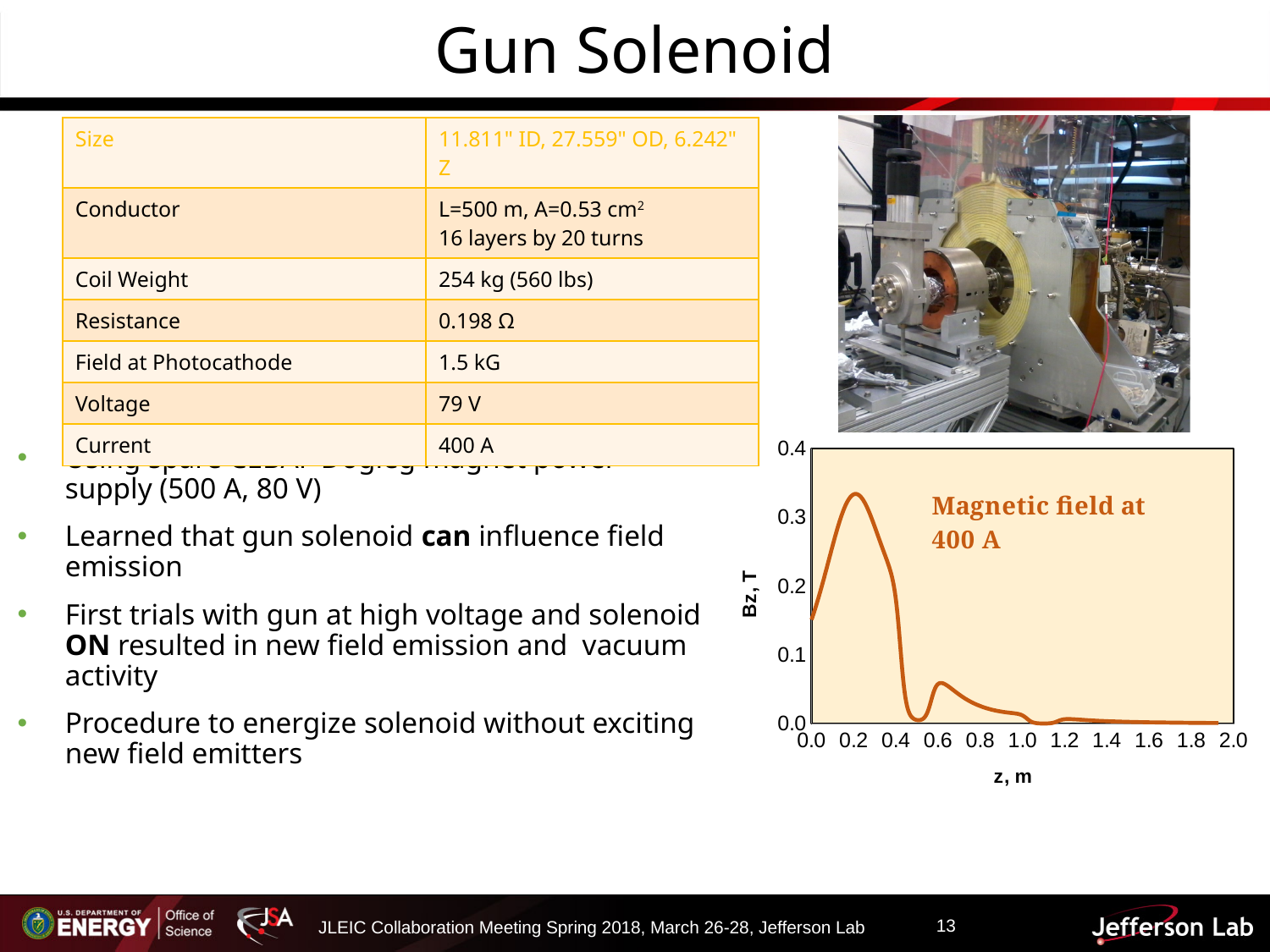
What is the title printed inside the chart? Magnetic field at 400 A Is the value of Bz at z = 0.2 m greater or less than 0.3? greater What is the label of the y axis of the chart? Bz, T What is the highest value shown on the y axis of the chart? 0.4 Is the value of Bz at z = 0.0 m greater or less than 0.2? less Is the value of Bz at z = 0.0 m greater or less than 0.1? greater Does Bz rise or fall along the x axis between z = 0.2 m and z = 0.5 m? fall What kind of chart is shown on the slide? line chart Which is larger, the value of Bz at z = 0.2 m or at z = 1.0 m? z = 0.2 m